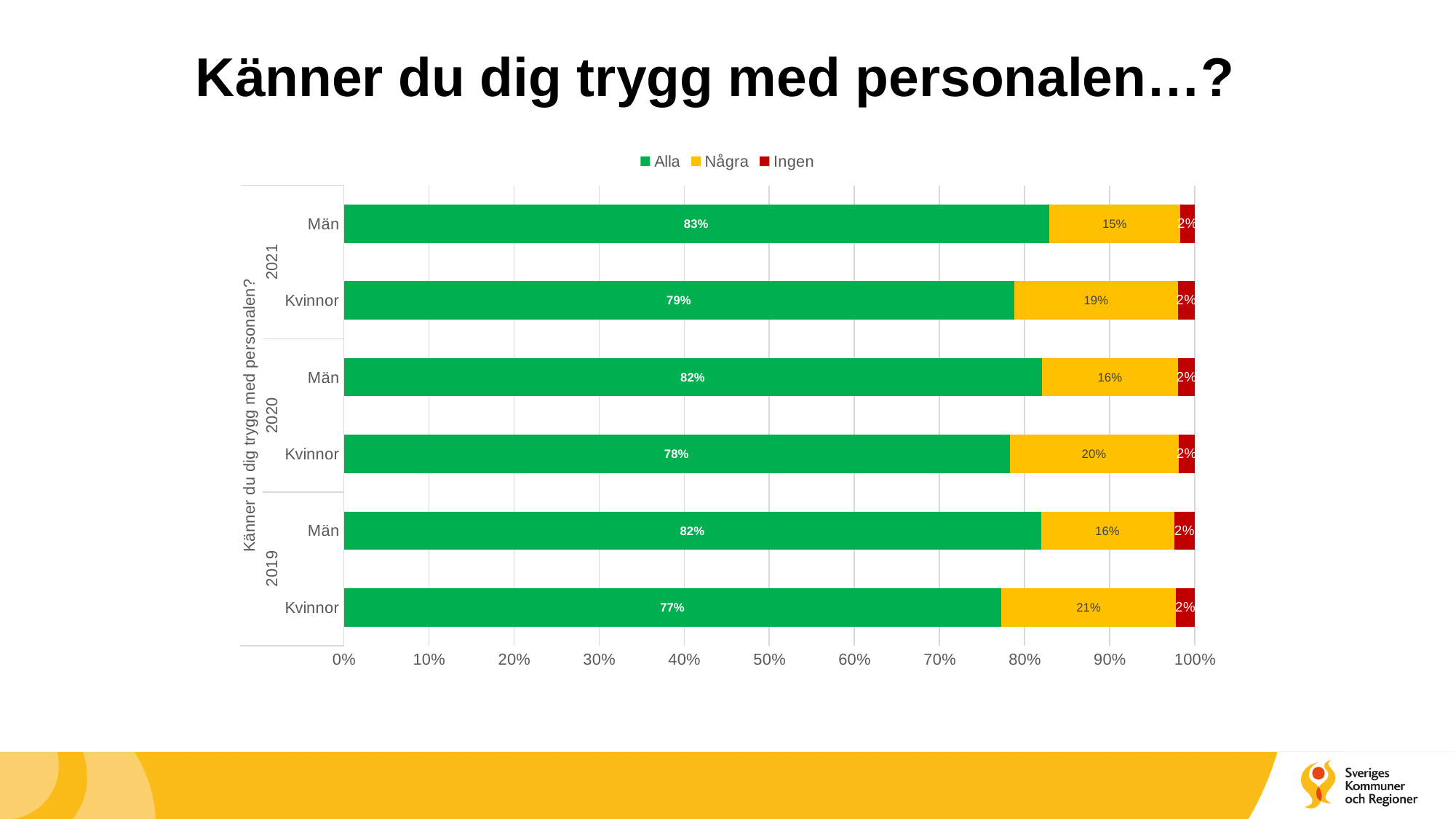
What is the value of "Alla" for Män in 2021? 83% What is the value of "Alla" for Kvinnor in 2020? 78% Which colour represents the "Ingen" series? Red How many bars are shown in the chart? 6 Which bar has the highest "Alla" value? Män 2021 What is the difference between the "Alla" values for Män and Kvinnor in 2021? 4 percentage points What kind of chart is shown on the slide? Stacked bar chart How many series does the legend list? 3 What is the value of "Några" for Kvinnor in 2019? 21% Which bar has the lowest "Alla" value? Kvinnor 2019 Which is larger, the "Några" value for Kvinnor in 2020 or for Män in 2020? Kvinnor in 2020 What is the value of "Ingen" for Män in 2020? 2%